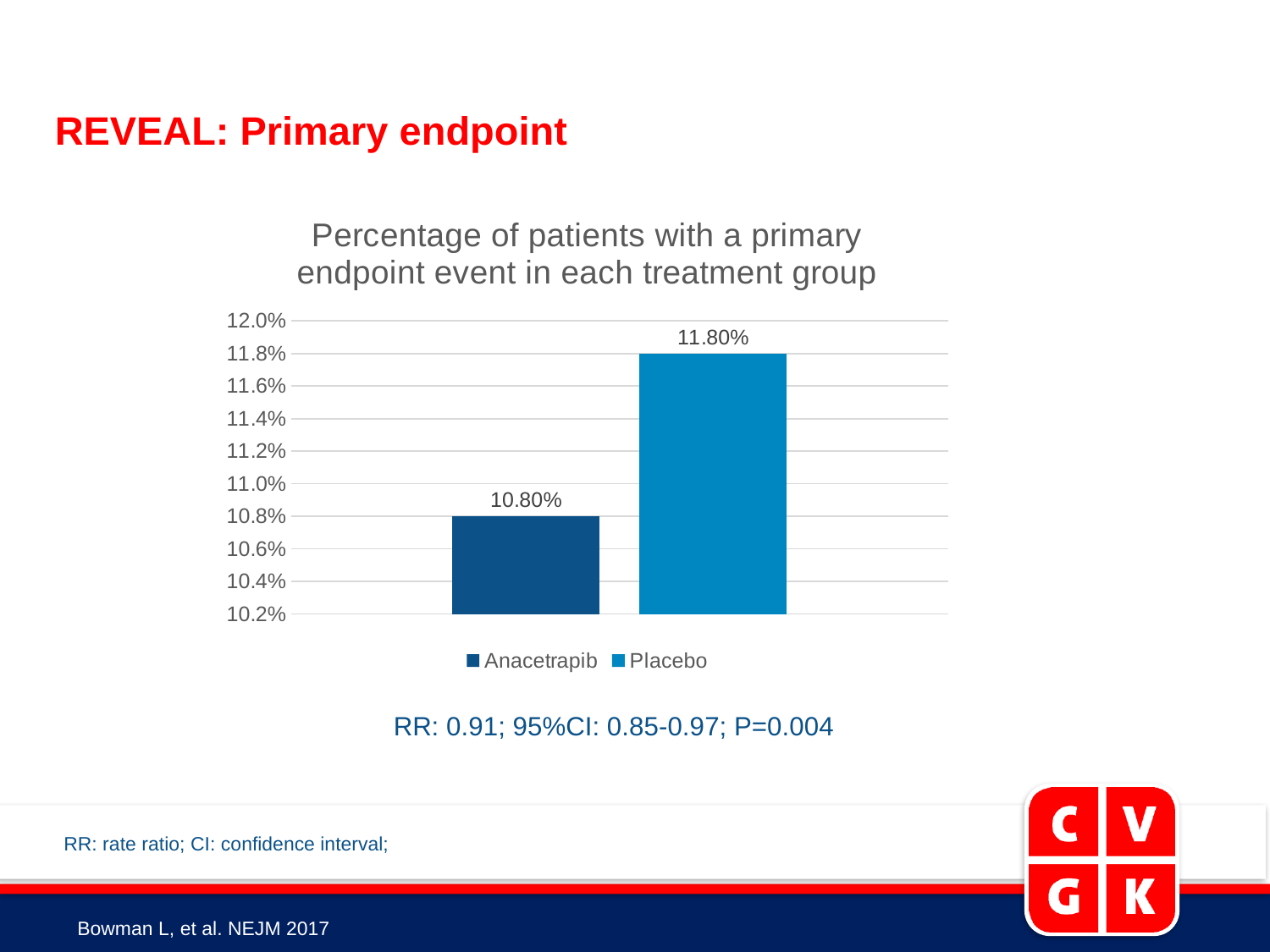
Which treatment group has the higher percentage of patients with a primary endpoint event? Placebo Is the value for Anacetrapib greater or less than the value for Placebo? less What kind of chart is shown on the slide? Bar chart Is the value for Anacetrapib greater or less than 11.0%? less Is the value for Placebo greater or less than 11.0%? greater What is the title of the chart? Percentage of patients with a primary endpoint event in each treatment group What percentage of patients had a primary endpoint event in the Anacetrapib group? 10.80% What percentage of patients had a primary endpoint event in the Placebo group? 11.80% Which treatment group has the lower percentage of patients with a primary endpoint event? Anacetrapib What is the difference in percentage points between the Placebo and Anacetrapib groups? 1.00% How many treatment groups are plotted in the chart? 2 How many series does the legend list? 2